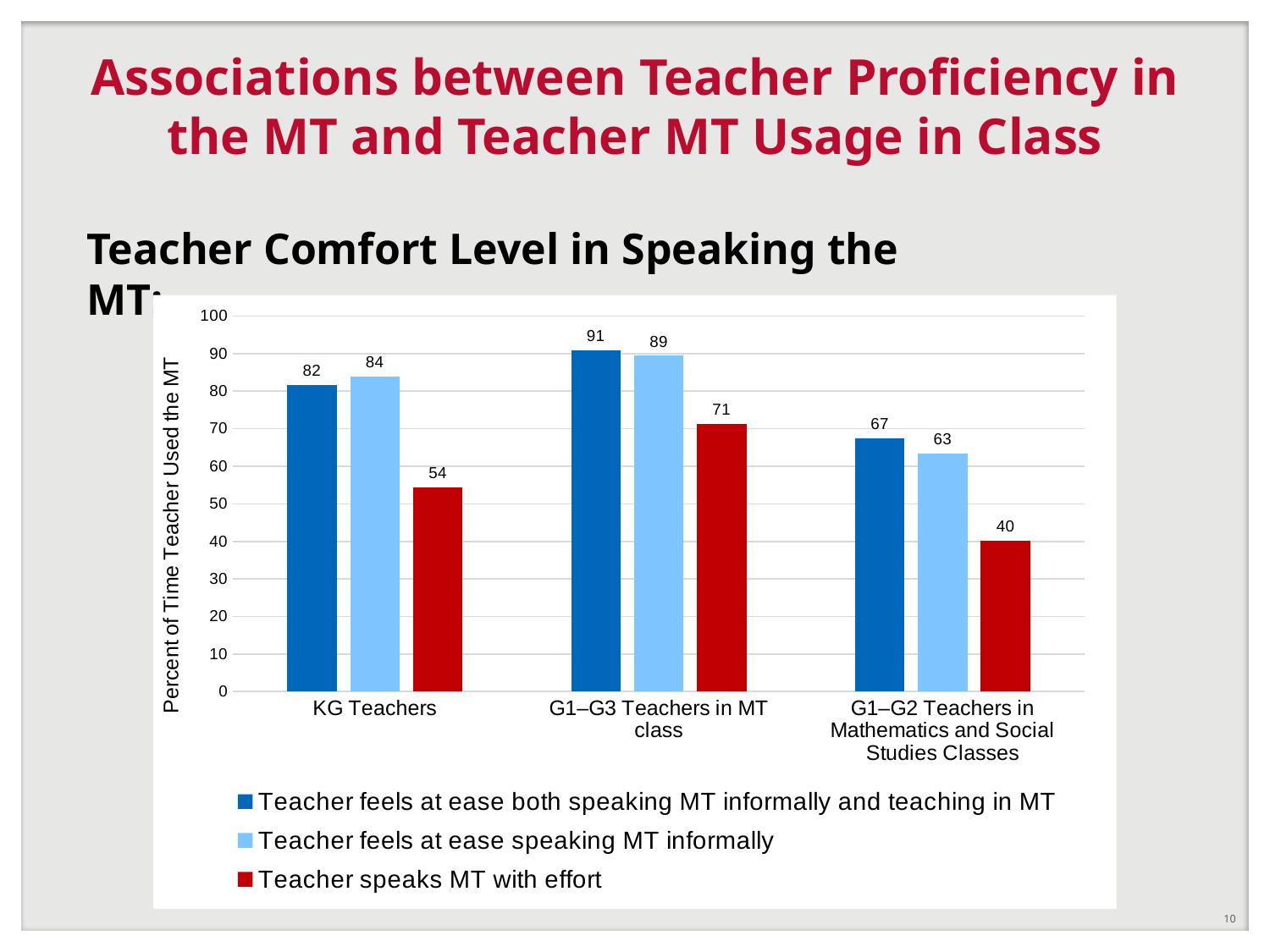
What is the value for G1–G2 Teachers in Mathematics and Social Studies Classes in the series 'Teacher feels at ease speaking MT informally'? 63 Which category has the lowest value in the series 'Teacher feels at ease both speaking MT informally and teaching in MT'? G1–G2 Teachers in Mathematics and Social Studies Classes What kind of chart is shown on the slide? bar chart How many series does the legend list? 3 What is the value for KG Teachers in the series 'Teacher speaks MT with effort'? 54 What is the difference between the 'Teacher feels at ease speaking MT informally' value and the 'Teacher speaks MT with effort' value for KG Teachers? 30 What is the value for G1–G3 Teachers in MT class in the series 'Teacher feels at ease both speaking MT informally and teaching in MT'? 91 Which category has the highest value in the series 'Teacher speaks MT with effort'? G1–G3 Teachers in MT class How many categories are shown on the x axis? 3 For G1–G2 Teachers in Mathematics and Social Studies Classes, which is larger: the value for 'Teacher feels at ease both speaking MT informally and teaching in MT' or the value for 'Teacher speaks MT with effort'? Teacher feels at ease both speaking MT informally and teaching in MT Is the value for G1–G3 Teachers in MT class in the series 'Teacher speaks MT with effort' greater or less than 60? greater What is the label of the vertical axis? Percent of Time Teacher Used the MT